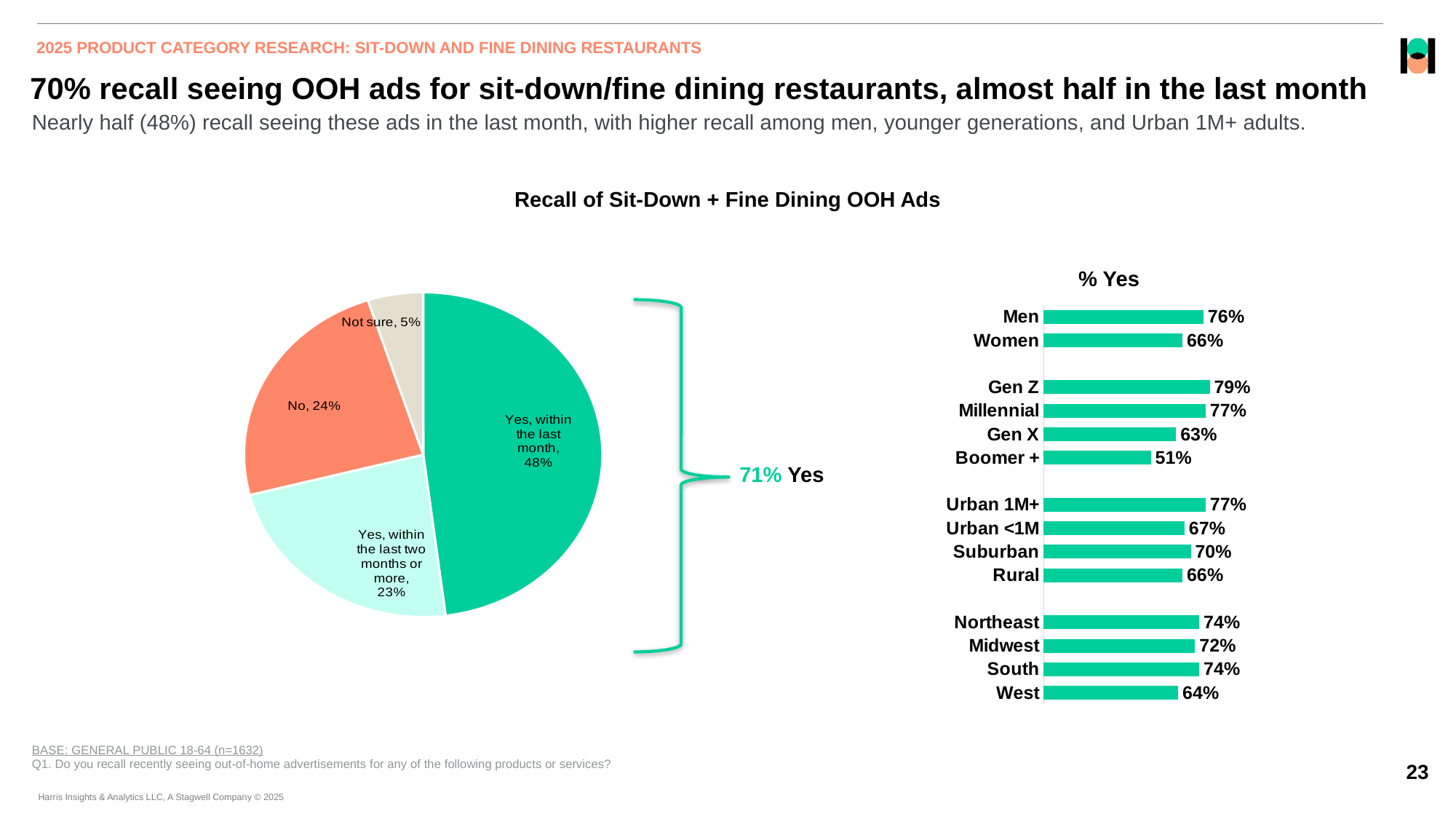
In the pie chart on the left, what share of respondents answered 'No'? 24% In the pie chart on the left, how many slices are there? 4 In the pie chart on the left, which slice is the smallest? Not sure In the '% Yes' bar chart on the right, how many categories are shown? 14 In the '% Yes' bar chart on the right, which category has the highest value? Gen Z In the '% Yes' bar chart on the right, which category has the lowest value? Boomer + In the '% Yes' bar chart on the right, what is the value for Gen Z? 79% In the pie chart on the left, what share of respondents said 'Yes, within the last month'? 48% In the '% Yes' bar chart on the right, what is the value for Boomer +? 51% What type of chart is the chart on the right of the slide? Bar chart In the '% Yes' bar chart on the right, which is larger, Urban 1M+ or Suburban? Urban 1M+ In the '% Yes' bar chart on the right, what is the difference between Men and Women? 10 percentage points